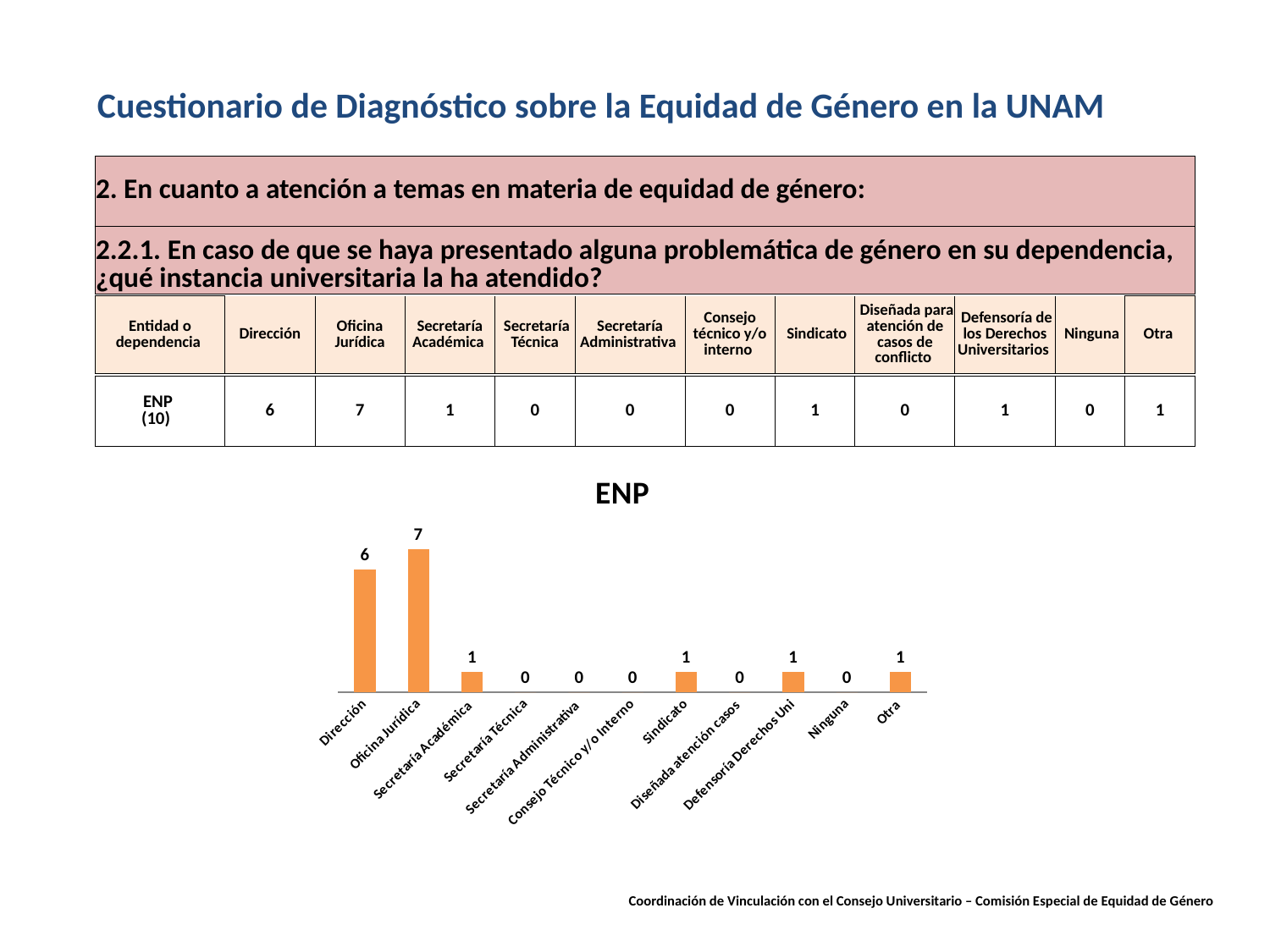
What is the value for Dirección in the ENP chart? 6 Which category has the highest value in the ENP chart? Oficina Jurídica What is the value for Oficina Jurídica in the ENP chart? 7 What is the title of the chart on the slide? ENP What kind of chart is shown on the slide? Bar chart What is the value for Secretaría Técnica in the ENP chart? 0 What is the difference between the values for Oficina Jurídica and Dirección in the ENP chart? 1 What is the difference between the values for Dirección and Otra in the ENP chart? 5 How many categories are shown on the x axis of the ENP chart? 11 What is the value for Secretaría Académica in the ENP chart? 1 How many categories in the ENP chart have a value of 0? 5 Which is larger in the ENP chart, Dirección or Sindicato? Dirección